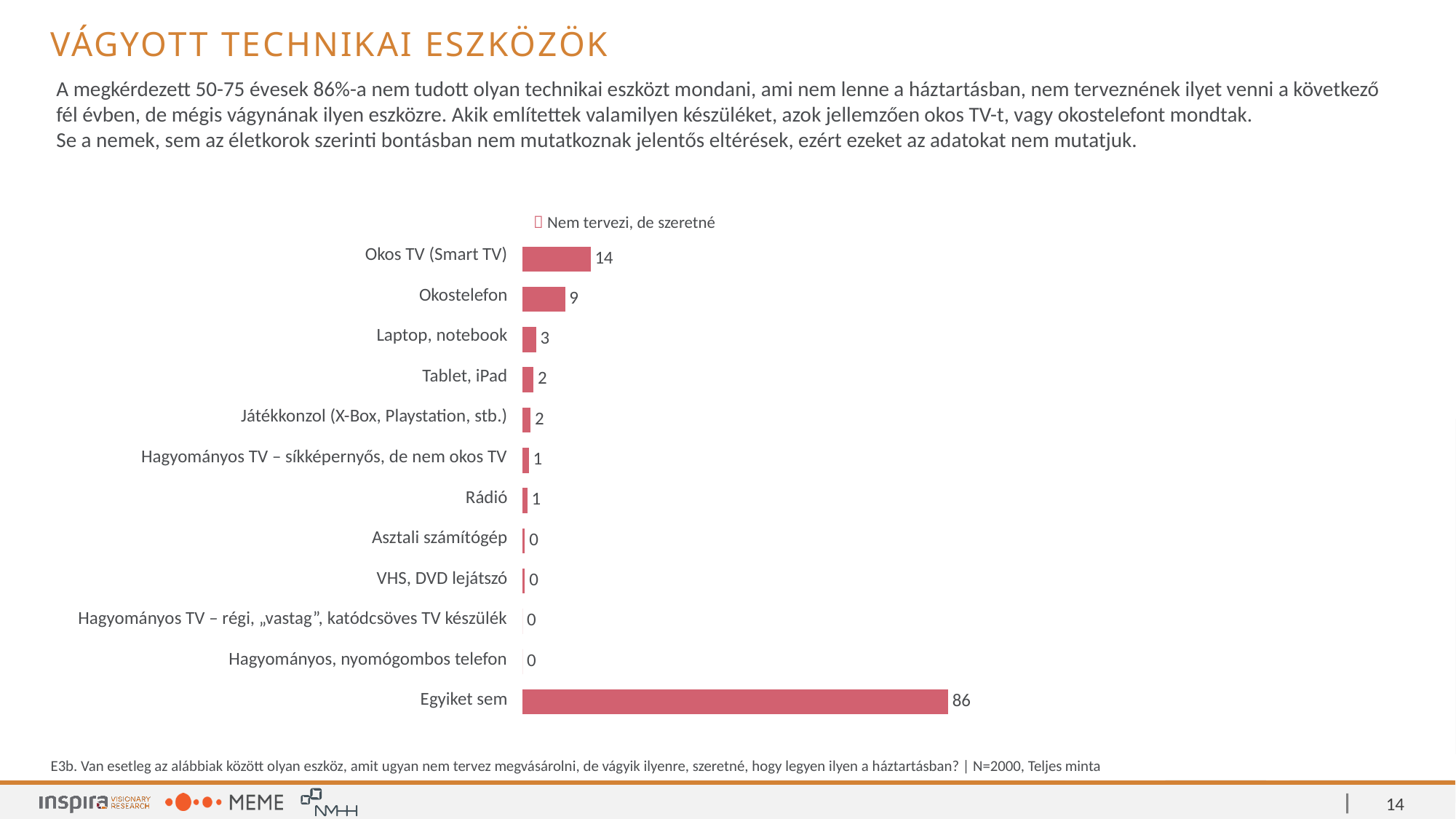
What kind of chart is shown on the slide? bar chart How many categories are shown in the chart? 12 What is the difference between the values for Egyiket sem and Okos TV (Smart TV)? 72 How many series does the legend list? 1 What is the value for Egyiket sem? 86 What is the value for Laptop, notebook? 3 What is the legend entry of the series shown in the chart? Nem tervezi, de szeretné What is the value for Okos TV (Smart TV)? 14 Which category has the highest value? Egyiket sem Which is larger, the value for Okostelefon or the value for Laptop, notebook? Okostelefon What is the difference between the values for Okos TV (Smart TV) and Okostelefon? 5 What is the value for Okostelefon? 9